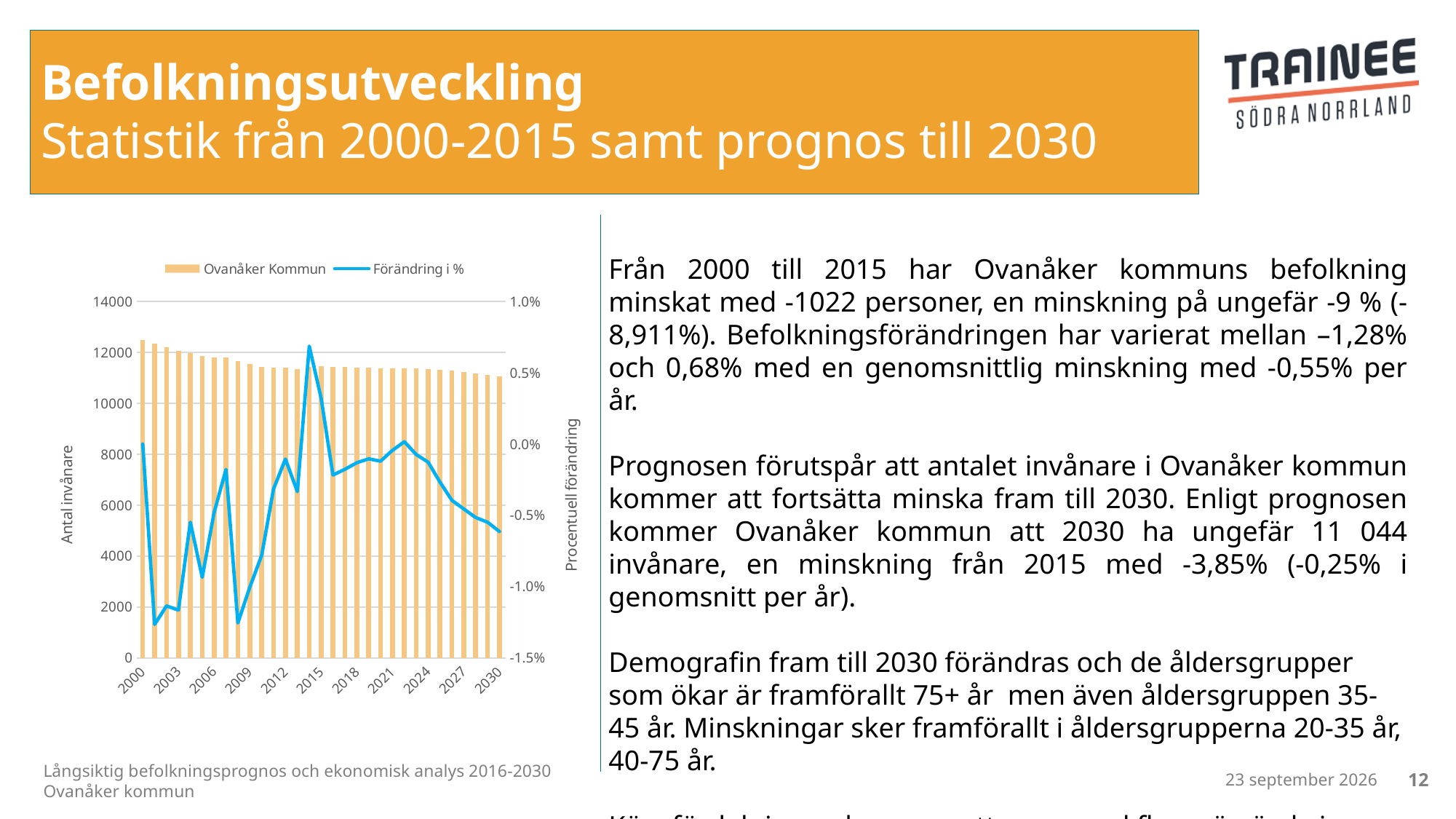
How many series does the chart legend list? 2 What is the title of the left vertical axis of the chart? Antal invånare Which year has the highest Ovanåker Kommun bar? 2000 Is the highest value of Förändring i % greater or less than 0.5%? greater Is the lowest value of Förändring i % greater or less than -1.0%? less What are the two series named in the chart legend? Ovanåker Kommun and Förändring i % Is the Ovanåker Kommun value for 2030 greater or less than 10000? greater Which is larger, the Ovanåker Kommun value for 2000 or for 2030? 2000 What kind of chart is shown on the slide? A combined bar and line chart Do the Ovanåker Kommun bars rise or fall from 2000 to 2030? fall